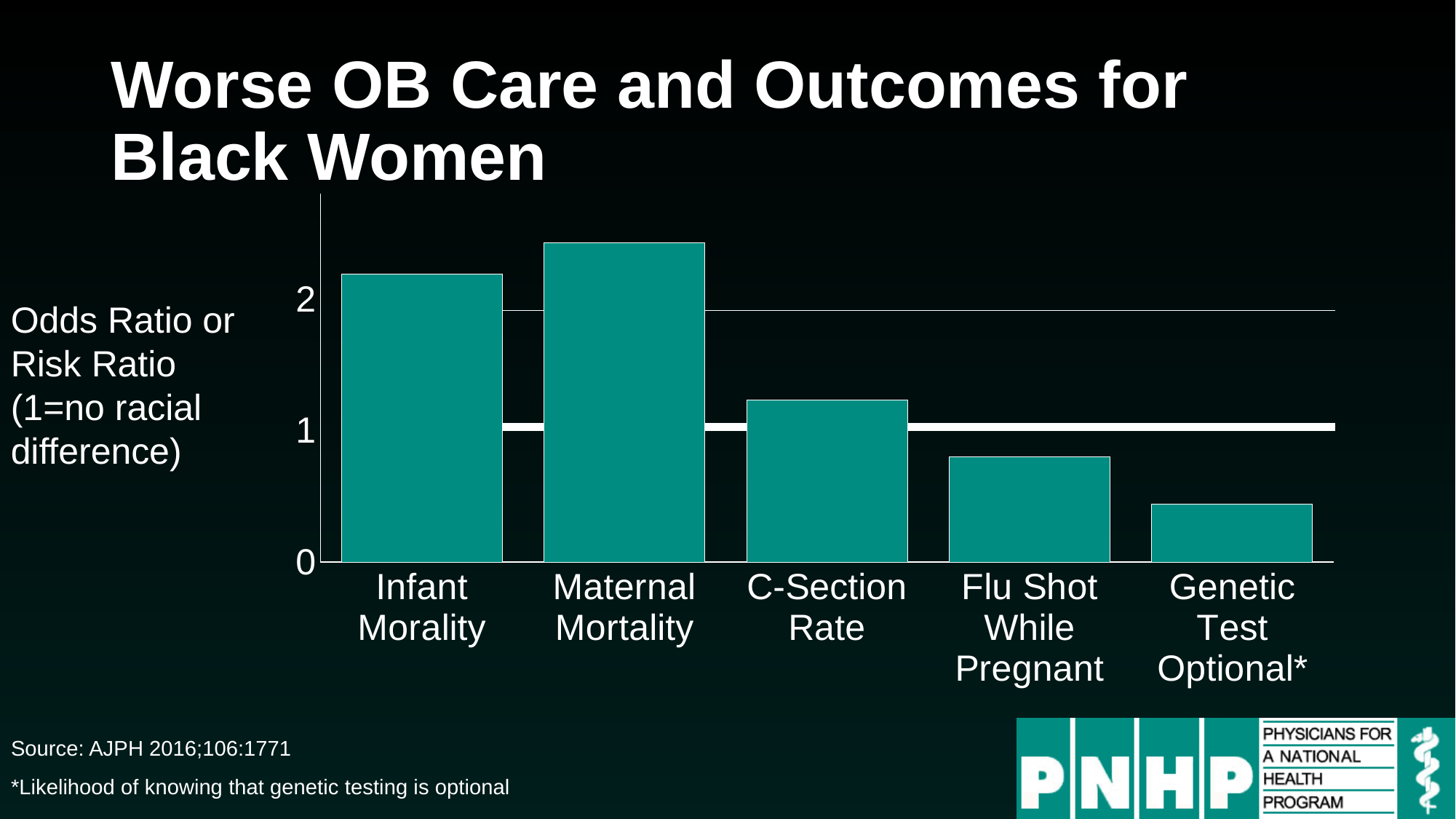
From C-Section Rate to Genetic Test Optional*, do the values rise or fall along the x axis? fall Which is larger, the value for Flu Shot While Pregnant or the value for Genetic Test Optional*? Flu Shot While Pregnant What is the title of the slide containing the chart? Worse OB Care and Outcomes for Black Women Is the value for Genetic Test Optional* greater or less than 1? less Which category has the lowest value? Genetic Test Optional* Is the value for C-Section Rate greater or less than 1? greater Is the value for Flu Shot While Pregnant greater or less than 1? less How many categories are plotted in the chart? 5 What kind of chart is shown on the slide? bar chart Which category has the highest value? Maternal Mortality Which is larger, the value for Maternal Mortality or the value for C-Section Rate? Maternal Mortality